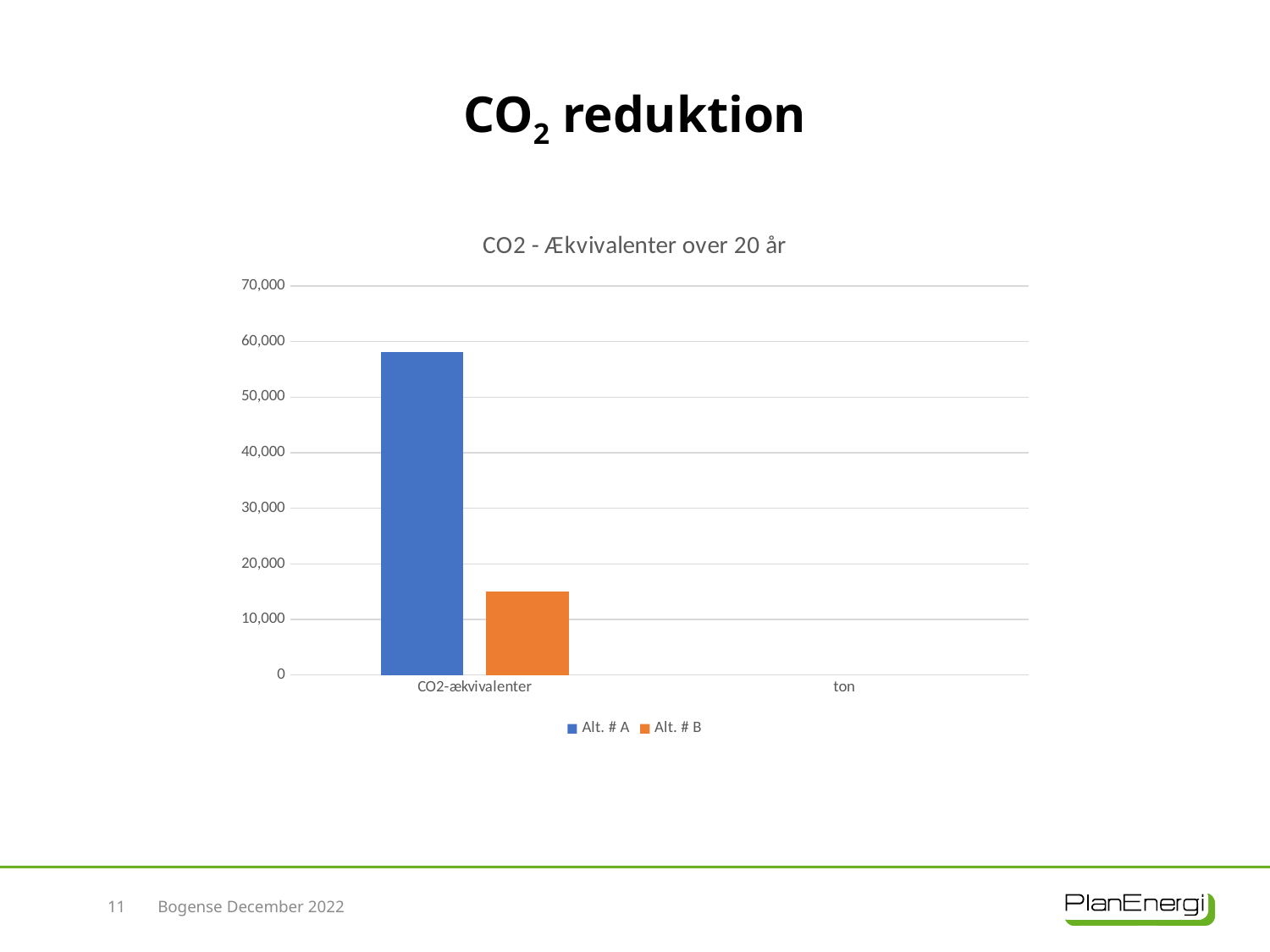
What kind of chart is shown on the slide? bar chart Which series has the lowest value for CO2-ækvivalenter? Alt. # B What is the title of the chart? CO2 - Ækvivalenter over 20 år Is the value for Alt. # B for CO2-ækvivalenter greater or less than 10,000? greater Is the value for Alt. # A for CO2-ækvivalenter greater or less than 60,000? less Which series has the highest value for CO2-ækvivalenter? Alt. # A Which series has the taller bar for CO2-ækvivalenter, Alt. # A or Alt. # B? Alt. # A How many series does the legend list? 2 How many category labels are shown on the x axis? 2 What are the two series named in the legend? Alt. # A and Alt. # B Is the value for Alt. # A for CO2-ækvivalenter greater or less than 50,000? greater